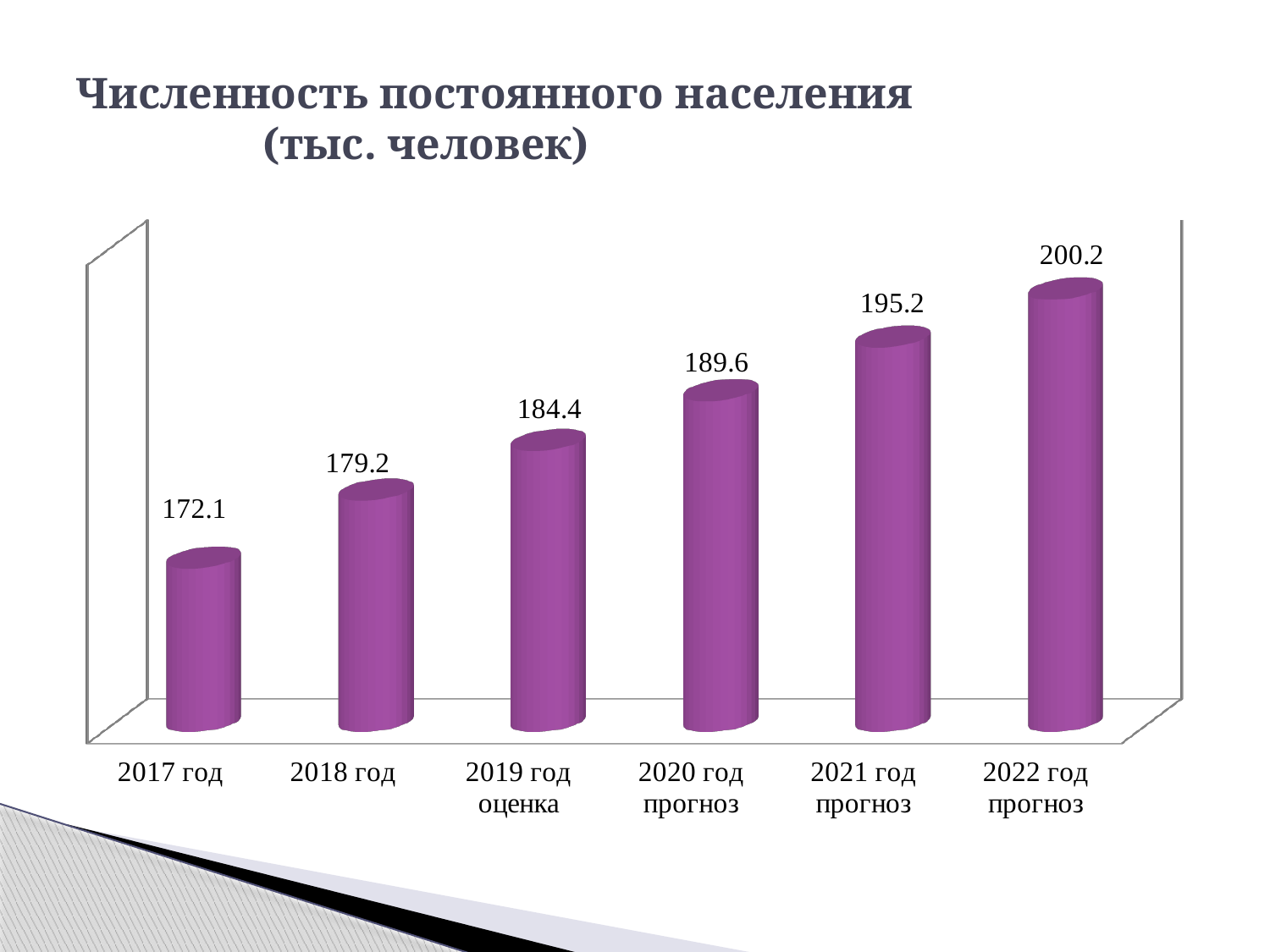
Which is larger, the value for 2021 год прогноз or the value for 2019 год оценка? 2021 год прогноз What is the difference between the values for 2022 год прогноз and 2017 год? 28.1 Which year has the highest value? 2022 год прогноз Do the values rise or fall from 2017 to 2022? rise How many bars are shown in the chart? 6 What kind of chart is this? bar chart What is the value for 2022 год прогноз? 200.2 What is the title of the chart? Численность постоянного населения (тыс. человек) What is the difference between the values for 2019 год оценка and 2018 год? 5.2 What is the value for 2017 год? 172.1 What is the value for 2020 год прогноз? 189.6 Which year has the lowest value? 2017 год